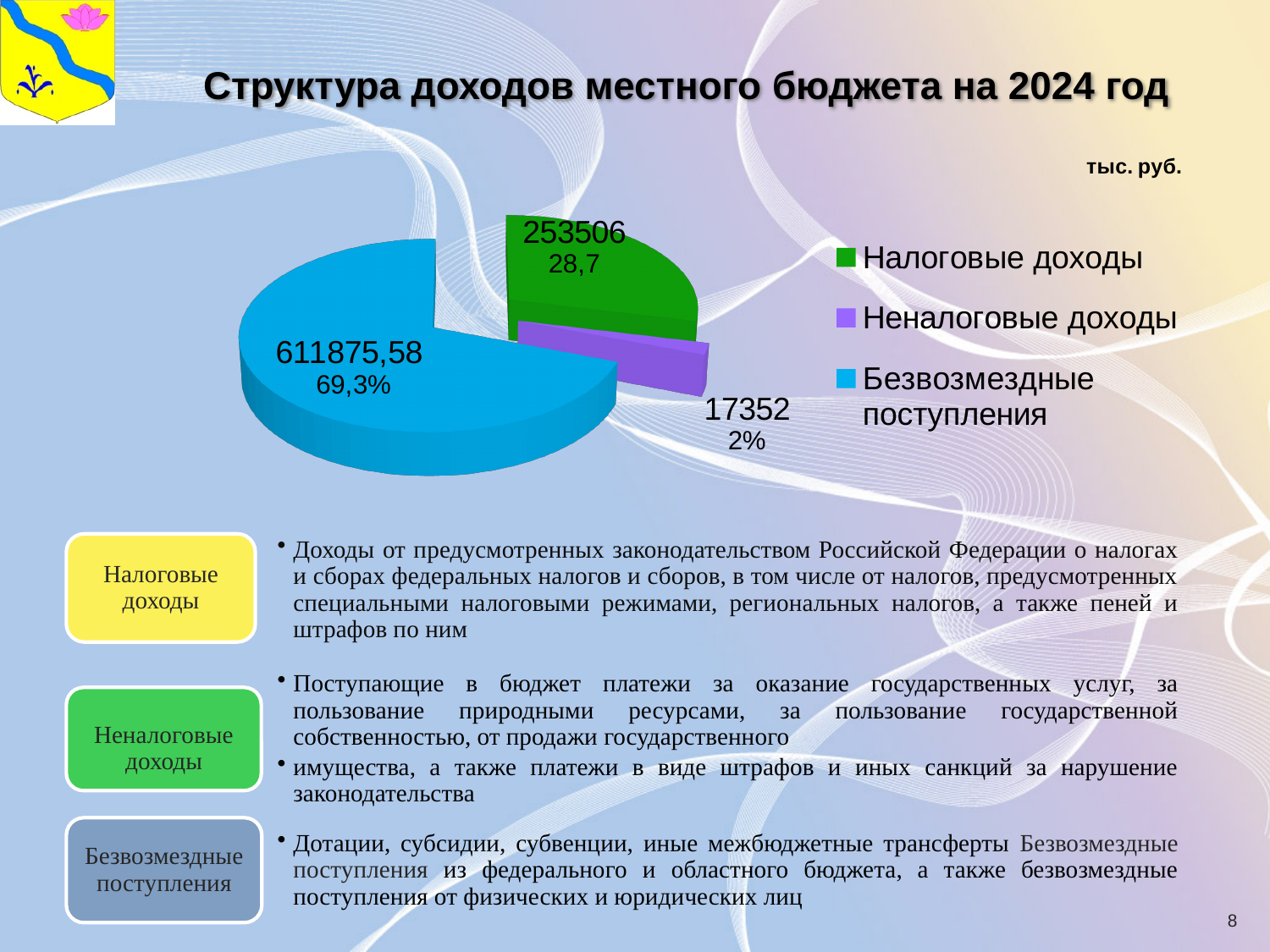
Which is larger, Налоговые доходы or Неналоговые доходы? Налоговые доходы What is the value for Безвозмездные поступления in the pie chart? 611875,58 What is the difference between the values for Безвозмездные поступления and Налоговые доходы? 358369,58 What share of the pie does Безвозмездные поступления represent? 69,3% What share of the pie does Неналоговые доходы represent? 2% What is the value for Неналоговые доходы in the pie chart? 17352 What type of chart is shown on the slide? pie chart Which category has the largest slice in the pie chart? Безвозмездные поступления What is the value for Налоговые доходы in the pie chart? 253506 How many categories does the pie chart have? 3 What is the title of the chart on the slide? Структура доходов местного бюджета на 2024 год Which category has the smallest slice in the pie chart? Неналоговые доходы